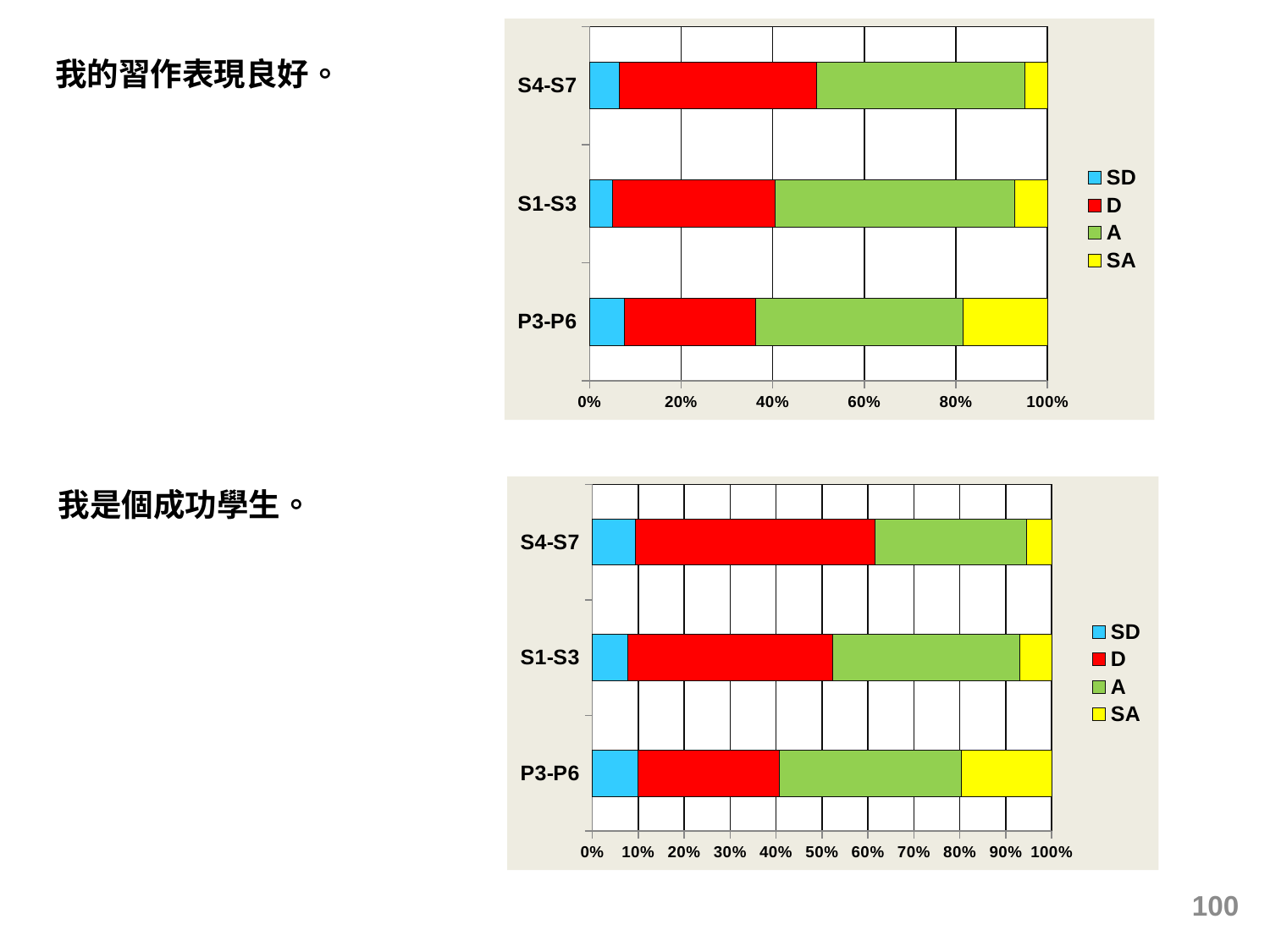
In the top chart, is the SA segment larger for P3-P6 or for S4-S7? P3-P6 In the top chart, is the combined SD and D share for S4-S7 greater or less than 40%? greater In the top chart, which category has the largest SA segment? P3-P6 In the bottom chart, which category has the largest D segment? S4-S7 What kind of chart is the top chart on the slide? Stacked bar chart In the top chart, is the SD share for S1-S3 greater or less than 20%? less In the bottom chart, which category has the smallest D segment? P3-P6 How many categories are shown on the y axis of the top chart? 3 What are the legend entries of the top chart, from top to bottom? SD, D, A, SA In the bottom chart, is the combined SD and D share for P3-P6 greater or less than 50%? less How many series does the legend of the bottom chart list? 4 In the bottom chart, which colour represents the series D? Red